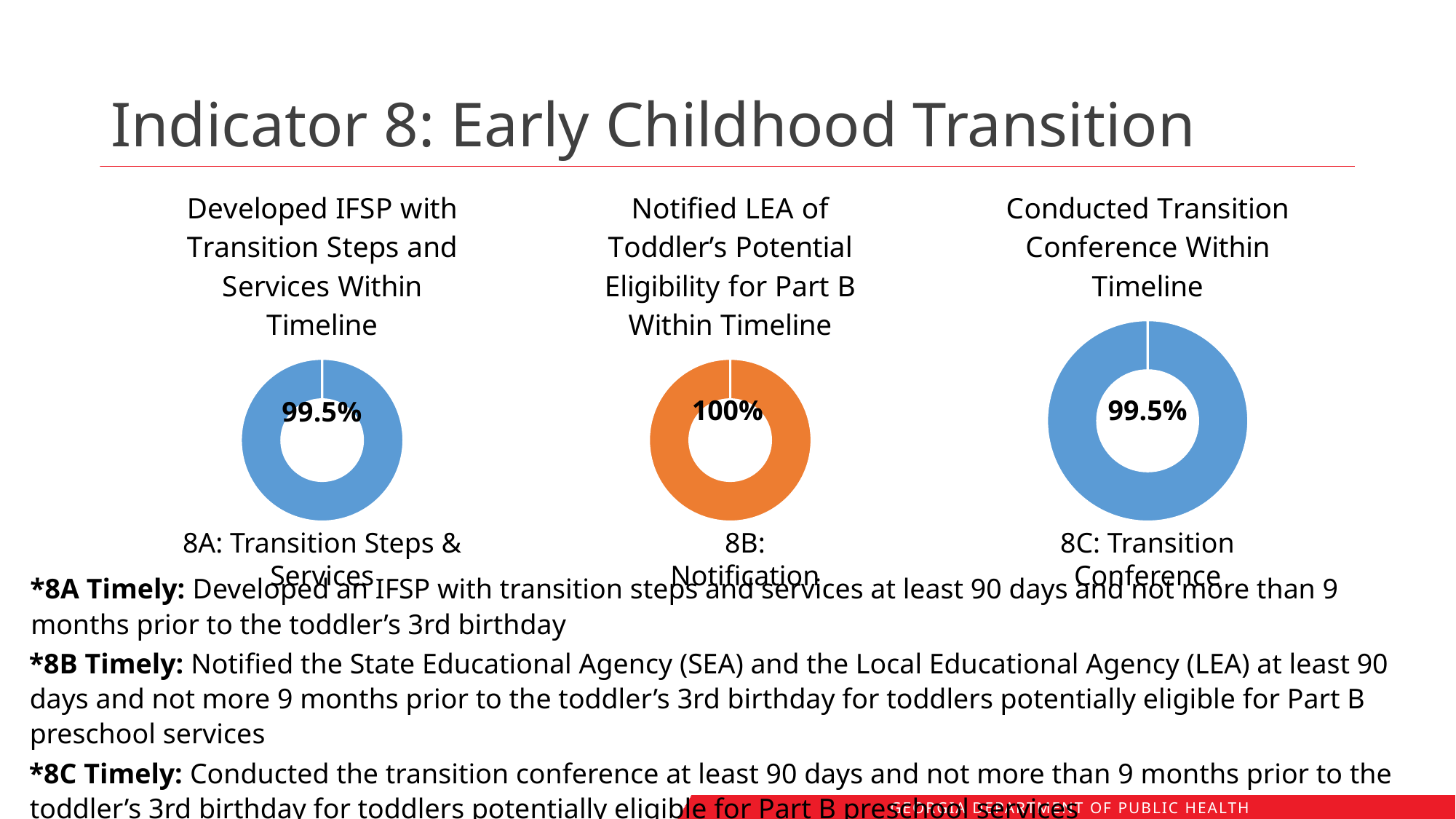
What is the difference between the percentage for 8B: Notification and the percentage for 8C: Transition Conference? 0.5% Which of the three indicators (8A, 8B, 8C) shows the highest percentage? 8B: Notification Is the percentage for 8B: Notification larger or smaller than the percentage for 8A: Transition Steps & Services? Larger What is the label shown beneath the rightmost donut chart? 8C: Transition Conference On the chart titled 'Conducted Transition Conference Within Timeline', what percentage is shown? 99.5% On the chart titled 'Developed IFSP with Transition Steps and Services Within Timeline', what percentage is shown in the centre of the donut? 99.5% On the chart titled 'Notified LEA of Toddler's Potential Eligibility for Part B Within Timeline', what percentage is shown? 100% What kind of chart is used for the 8A: Transition Steps & Services indicator? Donut (pie) chart How many donut charts are shown on the slide? 3 Do the charts for 8A: Transition Steps & Services and 8C: Transition Conference show the same percentage? Yes Which indicator's donut chart is coloured orange? 8B: Notification